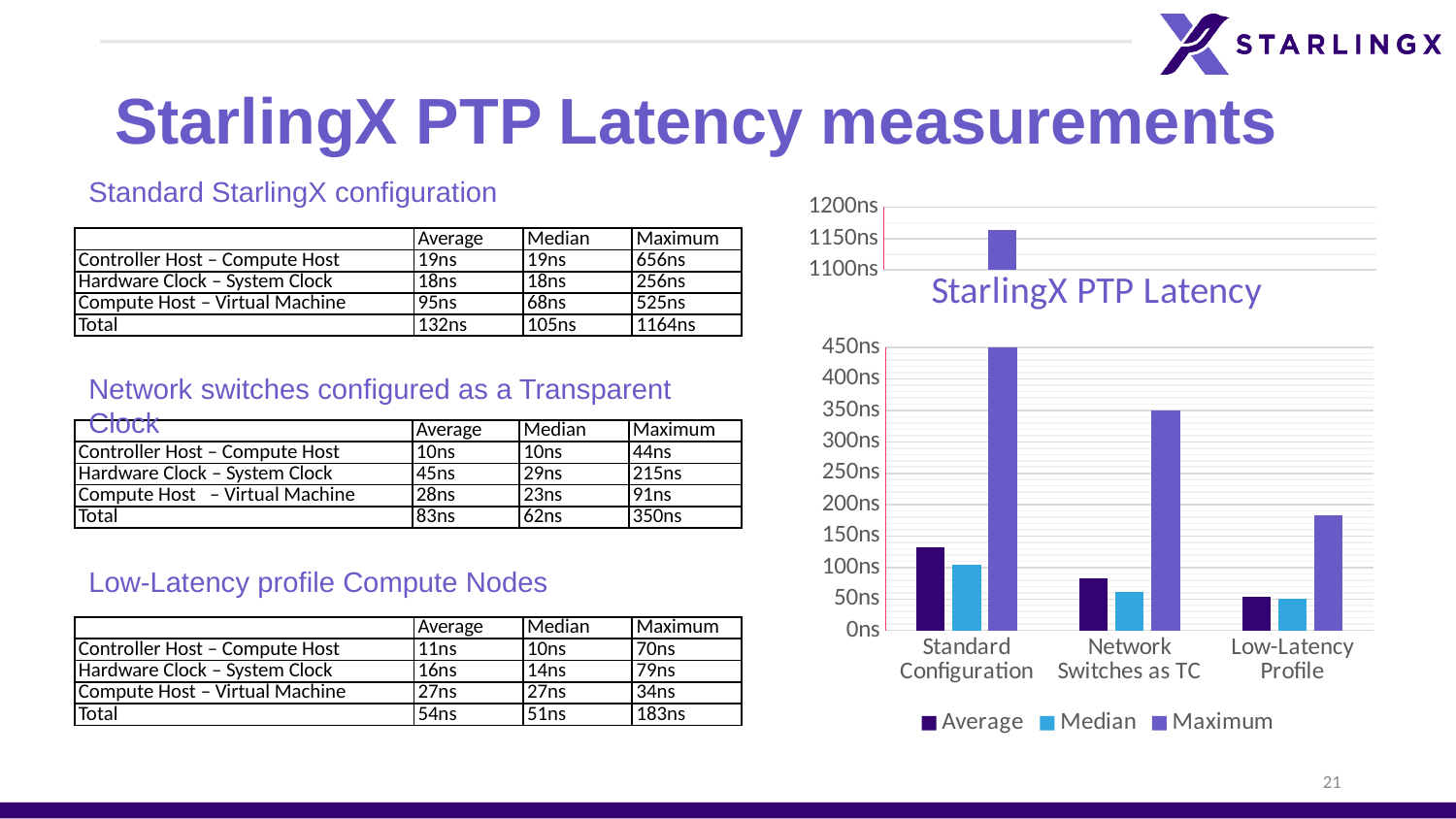
How many series does the chart legend list? 3 What type of chart is shown on the slide? bar chart Which is larger, the Average value for Standard Configuration or the Average value for Network Switches as TC? Standard Configuration Is the Maximum value for Standard Configuration greater or less than 1100ns? greater Which category has the highest Maximum bar in the chart? Standard Configuration Which category has the lowest Maximum bar in the chart? Low-Latency Profile Is the Average value for Standard Configuration greater or less than 100ns? greater Which legend entry is shown in the lightest blue colour in the chart? Median Is the Maximum value for Low-Latency Profile greater or less than 200ns? less What is the title of the chart on the slide? StarlingX PTP Latency How many categories are shown along the x axis of the chart? 3